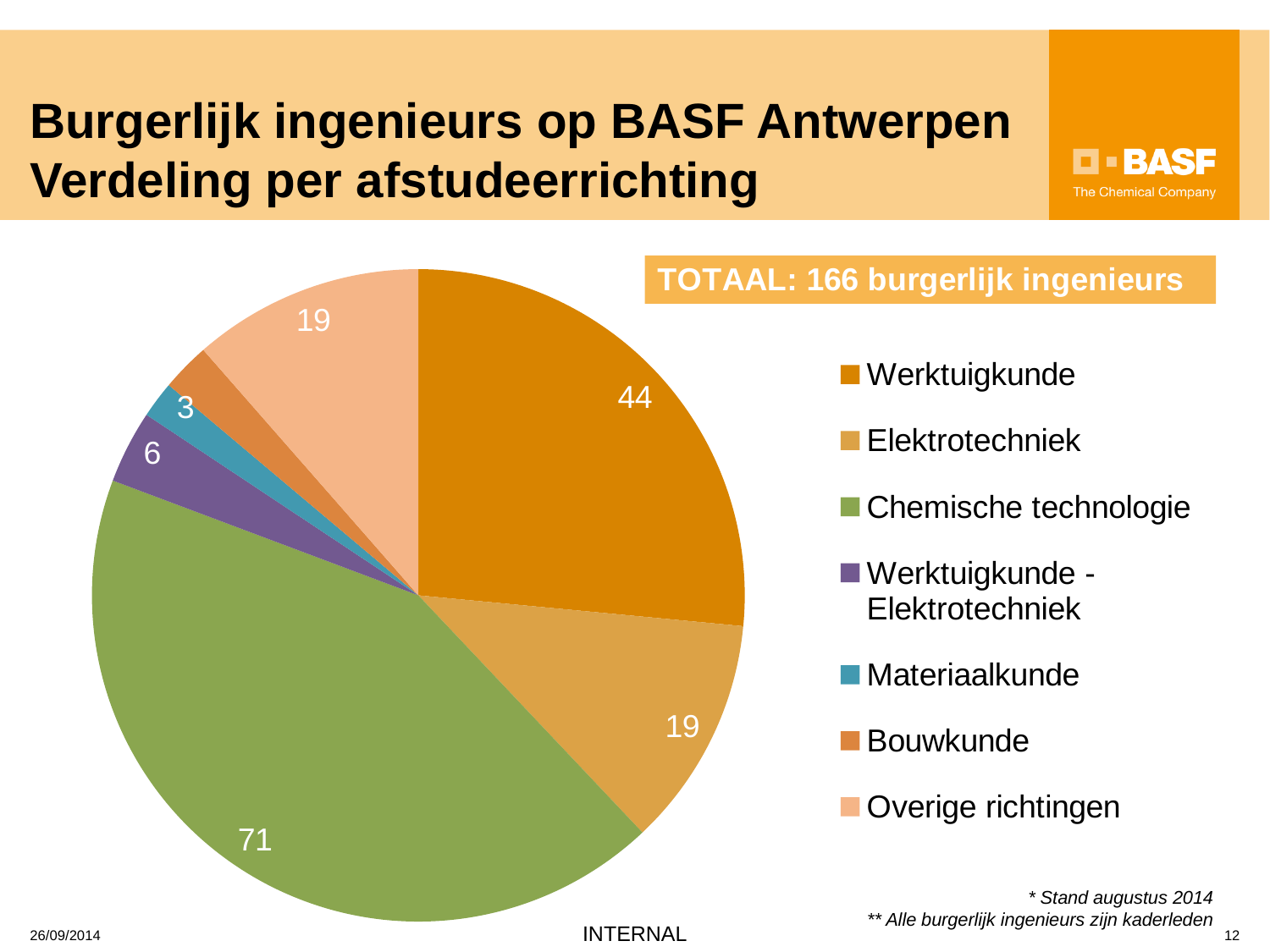
How many categories does the legend list? 7 What is the difference between the Chemische technologie and Werktuigkunde values? 27 What type of chart is shown on the slide? Pie chart Which afstudeerrichting has the largest slice of the pie? Chemische technologie What total number of burgerlijk ingenieurs is stated on the slide? 166 How many burgerlijk ingenieurs are in the Chemische technologie slice? 71 What is the value shown for Werktuigkunde? 44 What is the value shown for Elektrotechniek? 19 Which labelled slice has the smallest value? Materiaalkunde What is the value shown for Werktuigkunde - Elektrotechniek? 6 What is the value shown for Materiaalkunde? 3 Which is larger, Werktuigkunde or Overige richtingen? Werktuigkunde